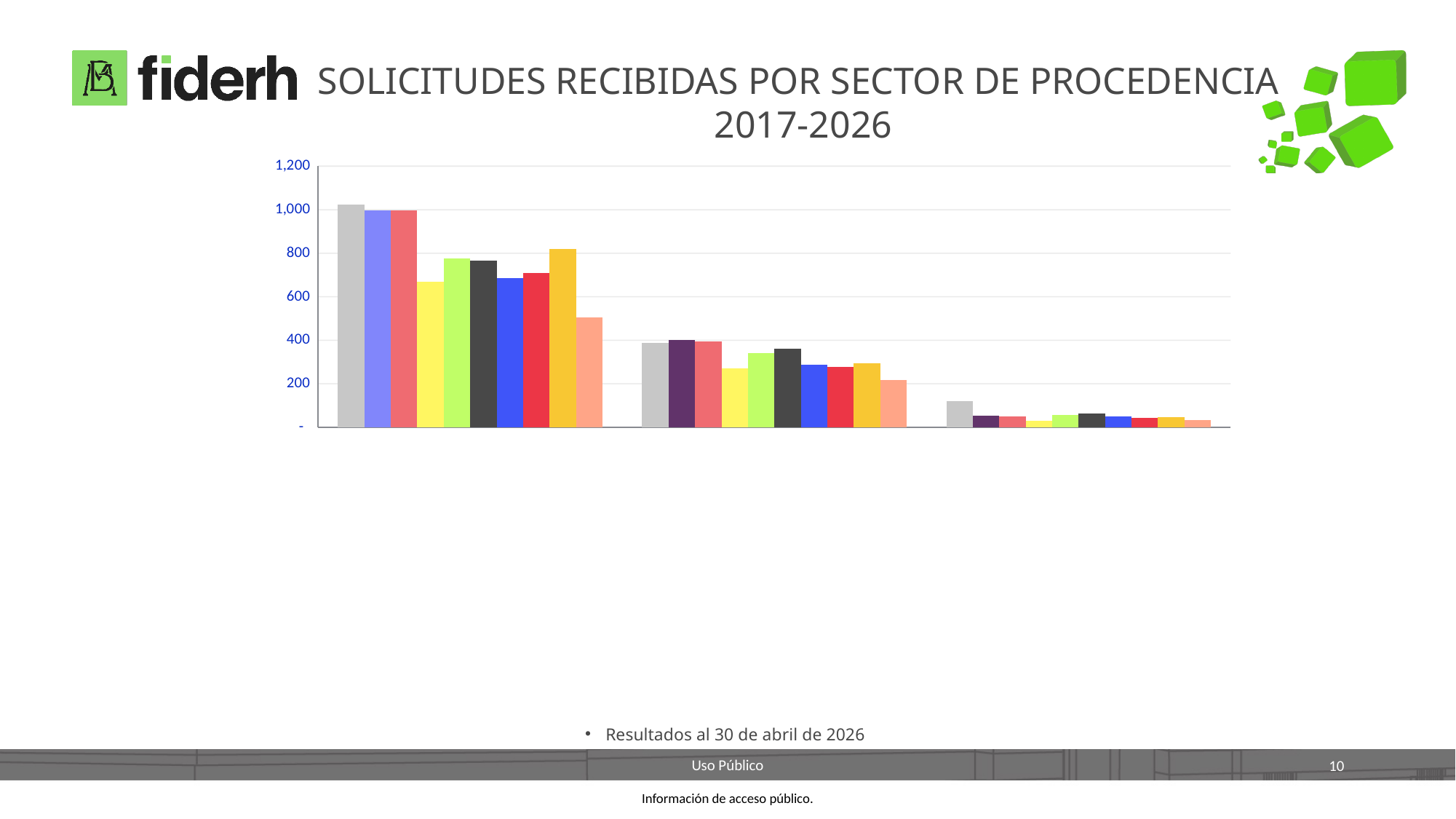
Is the value of the first (grey) bar in the rightmost group greater or less than 200? less Is the value of the fourth (yellow) bar in the middle group greater or less than 400? less What kind of chart is shown on the slide? bar chart Is the value of the first (grey) bar in the leftmost group greater or less than 800? greater How many bars are in the leftmost group of the chart? 10 What is the title of the chart on the slide? SOLICITUDES RECIBIDAS POR SECTOR DE PROCEDENCIA 2017-2026 Do the bar heights generally rise or fall moving from the leftmost group to the rightmost group? fall How many groups of bars does the chart show? 3 Which group of bars has the tallest bars: the leftmost, middle or rightmost group? leftmost What is the highest value shown on the vertical axis of the chart? 1,200 Which group of bars has the shortest bars: the leftmost, middle or rightmost group? rightmost